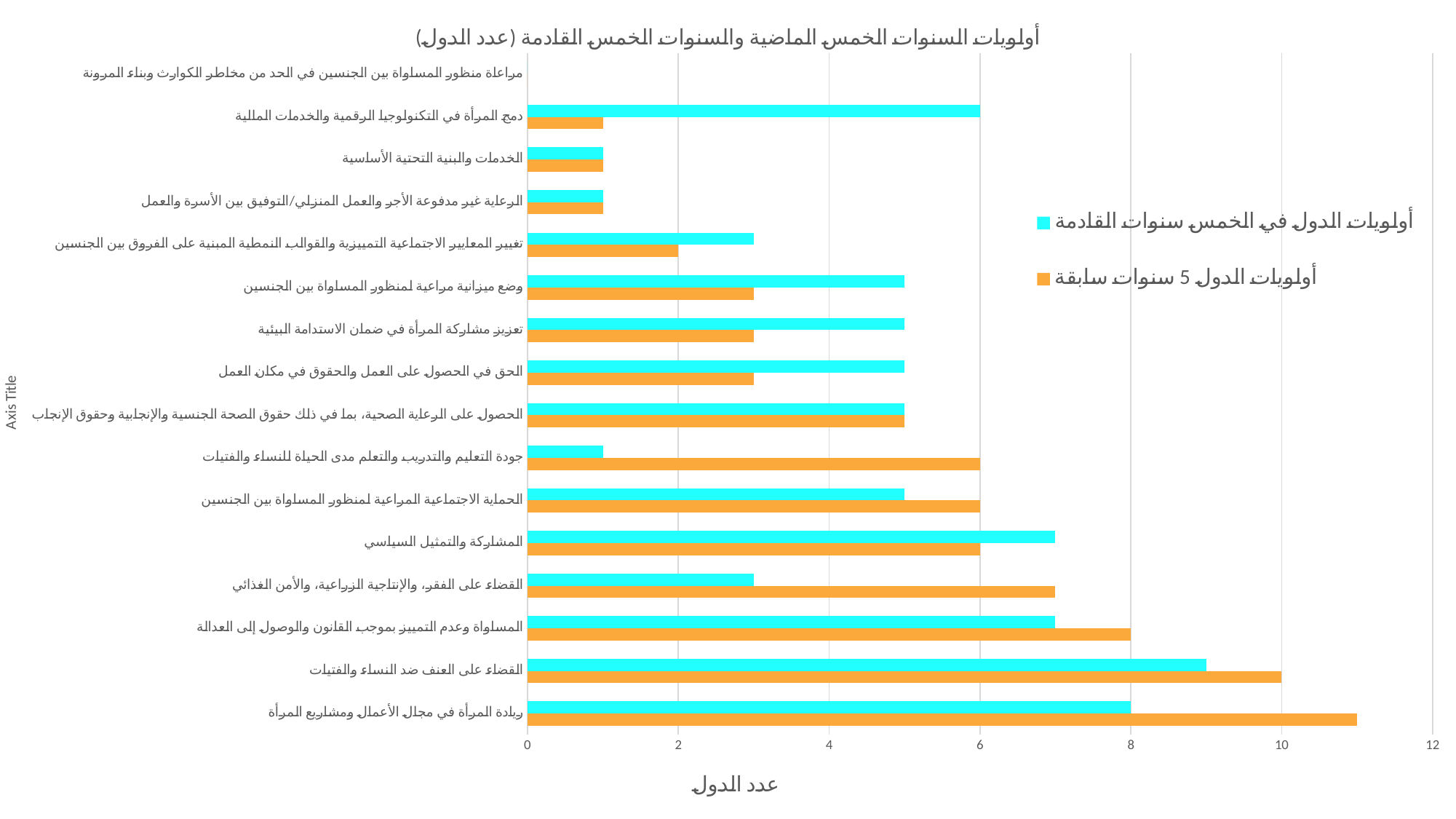
Which category has the highest value in the 'أولويات الدول في الخمس سنوات القادمة' series? القضاء على العنف ضد النساء والفتيات What is the value of the 'أولويات الدول في الخمس سنوات القادمة' series for 'ريادة المرأة في مجال الأعمال ومشاريع المرأة'? 8 How many series does the legend list? 2 Is the 'أولويات الدول 5 سنوات سابقة' value for 'ريادة المرأة في مجال الأعمال ومشاريع المرأة' greater or less than 10? greater What is the value of the 'أولويات الدول في الخمس سنوات القادمة' series for 'دمج المرأة في التكنولوجيا الرقمية والخدمات المالية'? 6 For 'جودة التعليم والتدريب والتعلم مدى الحياة للنساء والفتيات', which series has the larger value? أولويات الدول 5 سنوات سابقة Which category has the highest value in the 'أولويات الدول 5 سنوات سابقة' series? ريادة المرأة في مجال الأعمال ومشاريع المرأة What is the difference between the 'أولويات الدول 5 سنوات سابقة' value for 'القضاء على العنف ضد النساء والفتيات' and the 'أولويات الدول في الخمس سنوات القادمة' value for 'ريادة المرأة في مجال الأعمال ومشاريع المرأة'? 2 What is the value of the 'أولويات الدول 5 سنوات سابقة' series for 'القضاء على العنف ضد النساء والفتيات'? 10 What is the value of the 'أولويات الدول 5 سنوات سابقة' series for 'المساواة وعدم التمييز بموجب القانون والوصول إلى العدالة'? 8 How many categories are listed on the vertical axis of the chart? 16 What kind of chart is shown on the slide? bar chart